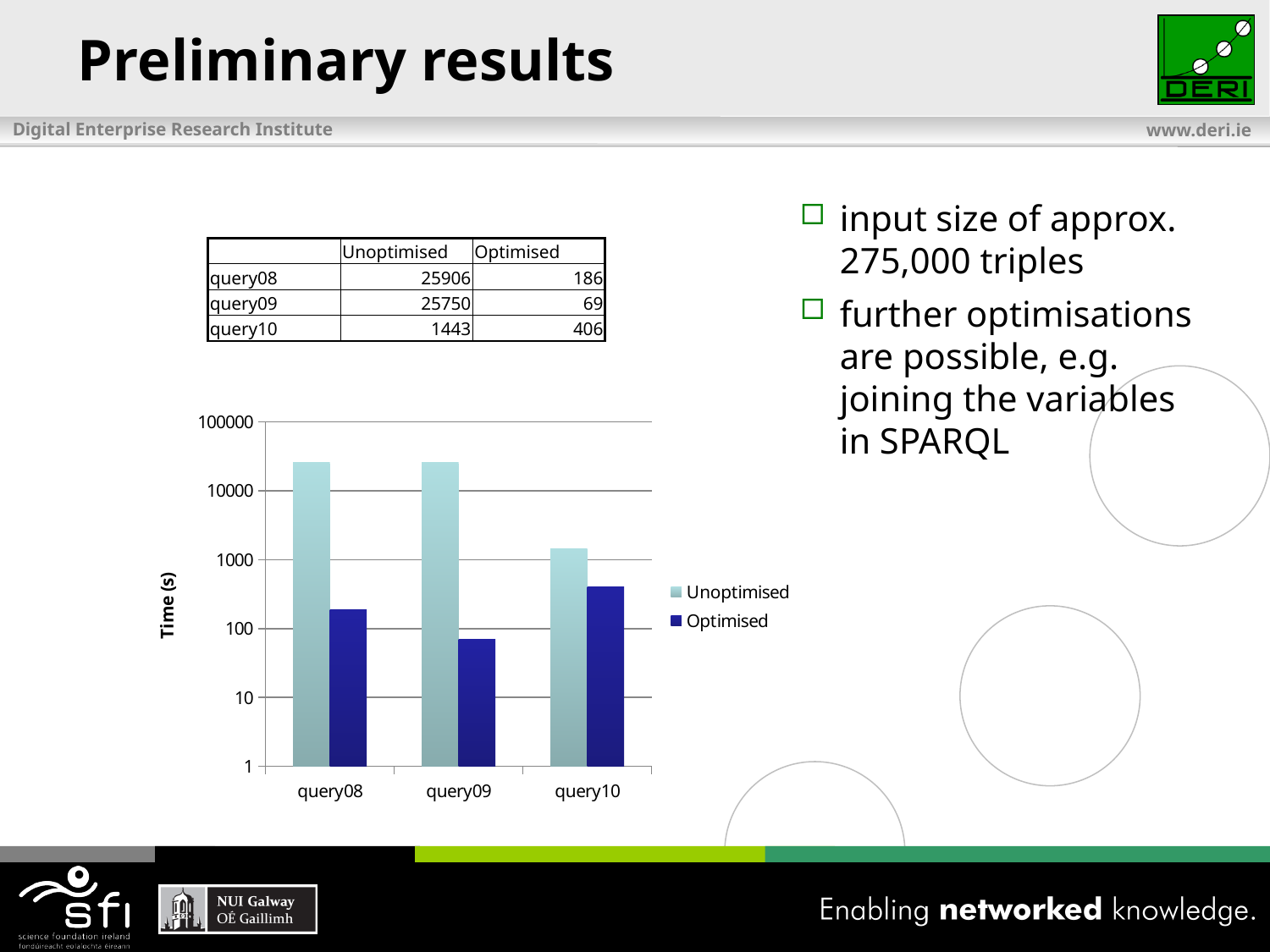
What is the Optimised time for query09? 69 What is the Optimised time for query10? 406 Is the Unoptimised value for query10 greater or less than 1000? greater Which query has the highest Optimised time? query10 How many query categories are shown on the x axis of the chart? 3 Which query has the lowest Unoptimised time? query10 What kind of chart is shown on the slide? bar chart What is the label on the y axis of the chart? Time (s) What is the difference between the Unoptimised and Optimised times for query08? 25720 How many series does the chart legend list? 2 Which is larger, the Optimised time for query08 or the Optimised time for query09? query08 What is the Unoptimised time for query08? 25906